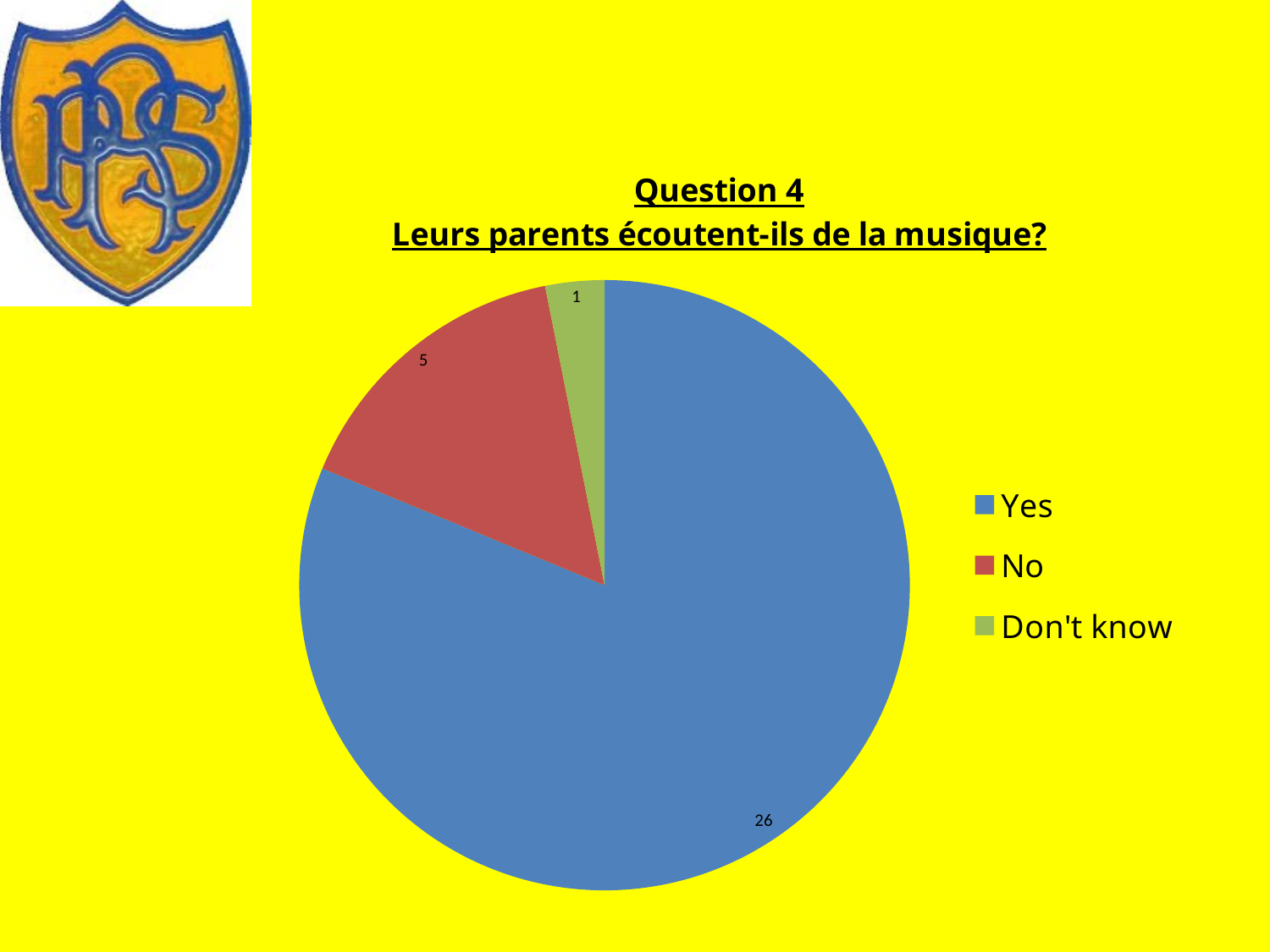
Which is larger, the value for No or the value for Don't know? No What is the value for Don't know? 1 What colour is the slice for No? red How many categories does the pie chart have? 3 What type of chart is shown on the slide? pie chart What is the value for No? 5 What is the value for Yes? 26 What is the difference between the values for No and Don't know? 4 What is the total of all the slices in the pie chart? 32 Which category has the smallest slice? Don't know What is the difference between the values for Yes and No? 21 Which category has the largest slice? Yes